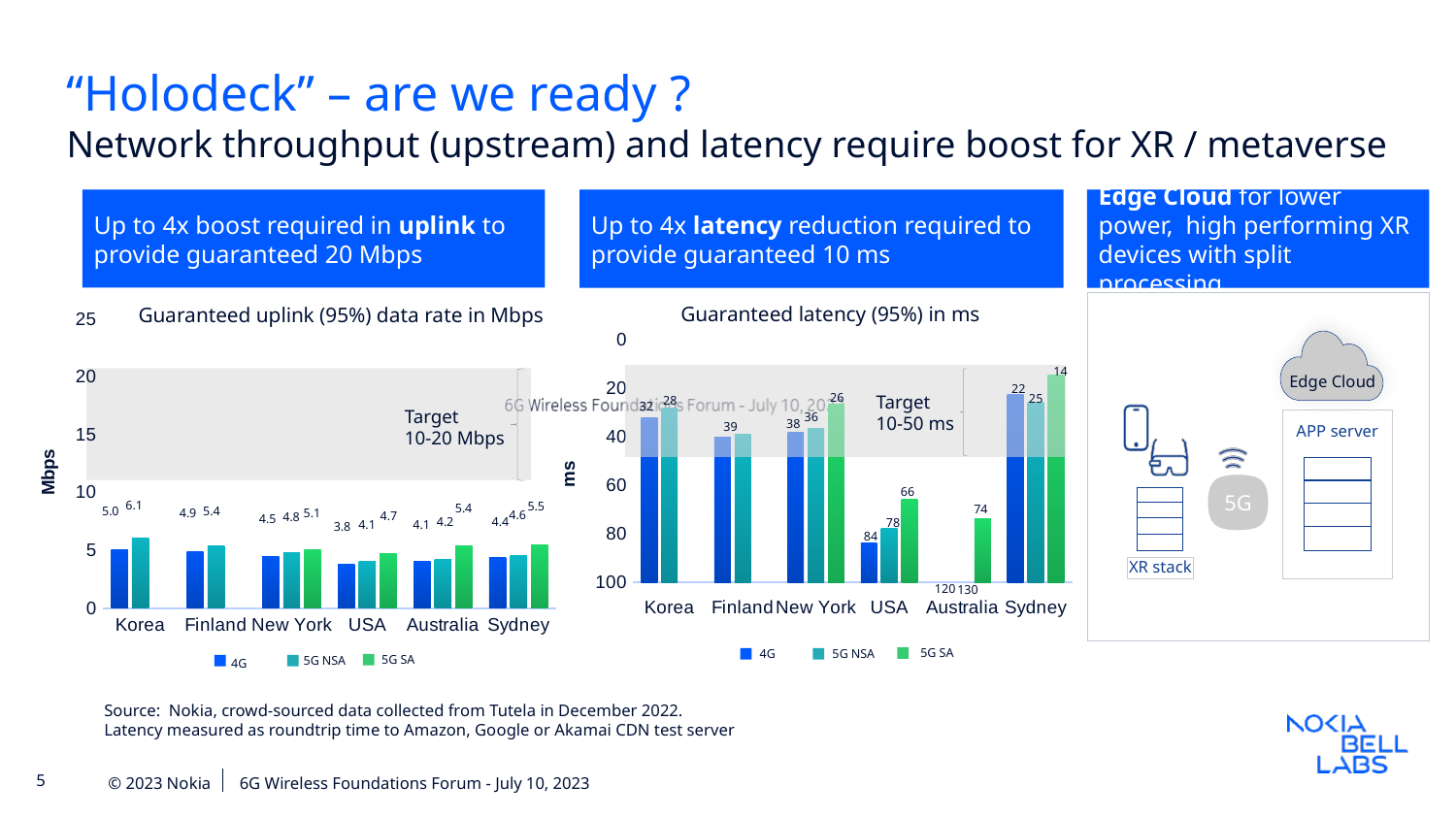
In the "Guaranteed uplink (95%) data rate in Mbps" chart, what is the 4G value for Korea? 5.0 How many series does the legend of the "Guaranteed latency (95%) in ms" chart list? 3 What target range is annotated on the "Guaranteed latency (95%) in ms" chart? 10-50 ms In the "Guaranteed latency (95%) in ms" chart, which category and series has the highest latency value? Australia, 5G NSA (130) In the "Guaranteed uplink (95%) data rate in Mbps" chart, which category has the lowest 4G value? USA In the "Guaranteed latency (95%) in ms" chart, what is the 4G value for USA? 84 In the "Guaranteed latency (95%) in ms" chart, is the 5G NSA value for Finland greater or less than 60? less In the "Guaranteed uplink (95%) data rate in Mbps" chart, what is the 5G SA value for Sydney? 5.5 What type of chart is the "Guaranteed uplink (95%) data rate in Mbps" chart? Bar chart In the "Guaranteed latency (95%) in ms" chart, which is larger: the 4G value for USA or the 4G value for Korea? USA How many categories are shown on the x axis of the "Guaranteed uplink (95%) data rate in Mbps" chart? 6 In the "Guaranteed uplink (95%) data rate in Mbps" chart, what is the difference between the 5G NSA and 4G values for Korea? 1.1